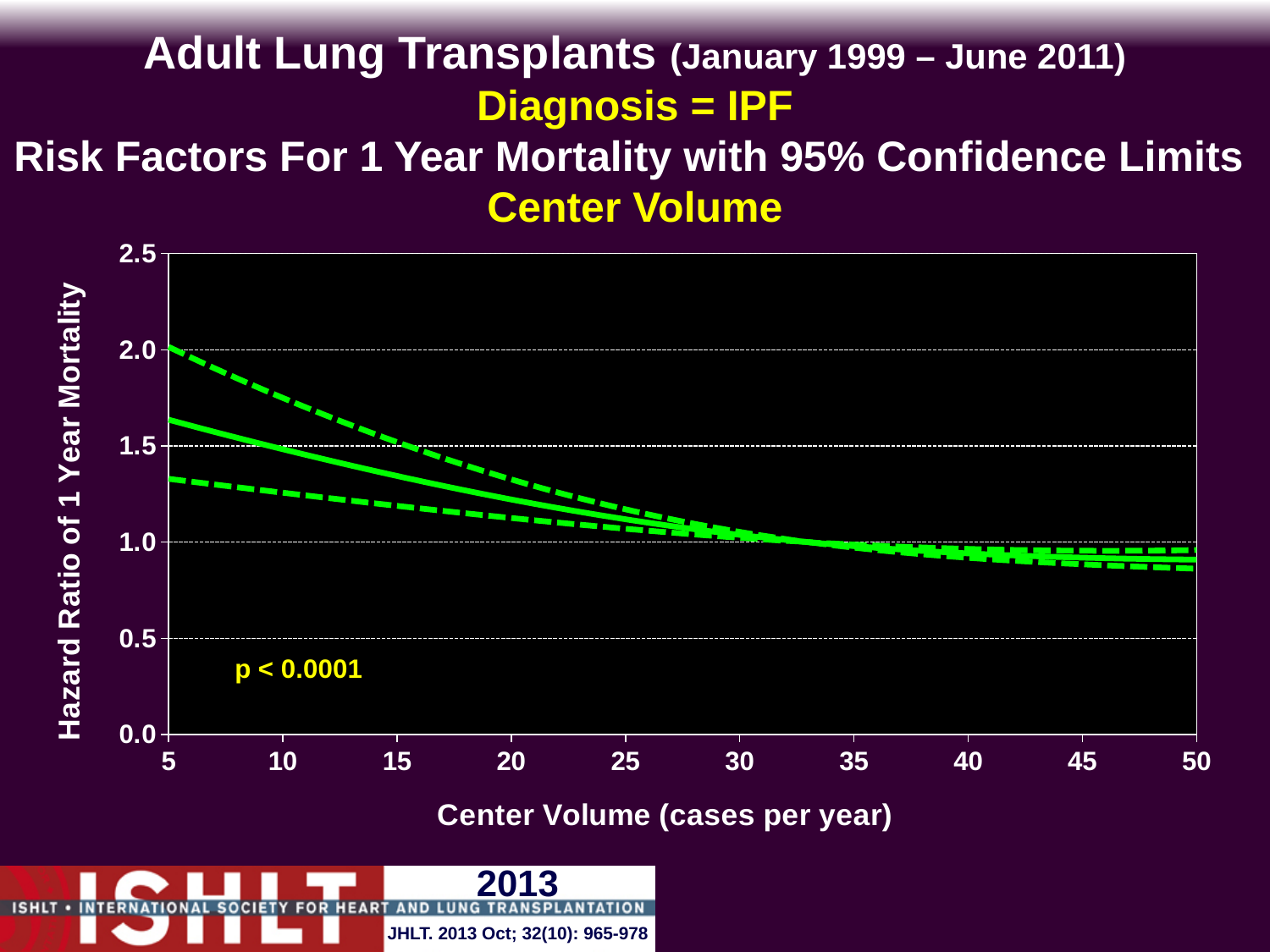
How many lines are plotted on the chart? 3 What p-value is printed on the chart? p < 0.0001 Is the hazard ratio on the solid line at a center volume of 20 cases per year greater or less than 1.5? less What is the label of the x axis? Center Volume (cases per year) Is the lower dashed confidence limit at a center volume of 5 cases per year greater or less than 1.0? greater Does the hazard ratio of 1 year mortality rise or fall as center volume increases along the x axis? fall What kind of chart is shown on the slide? line chart Is the hazard ratio on the solid line at a center volume of 50 cases per year greater or less than 1.0? less